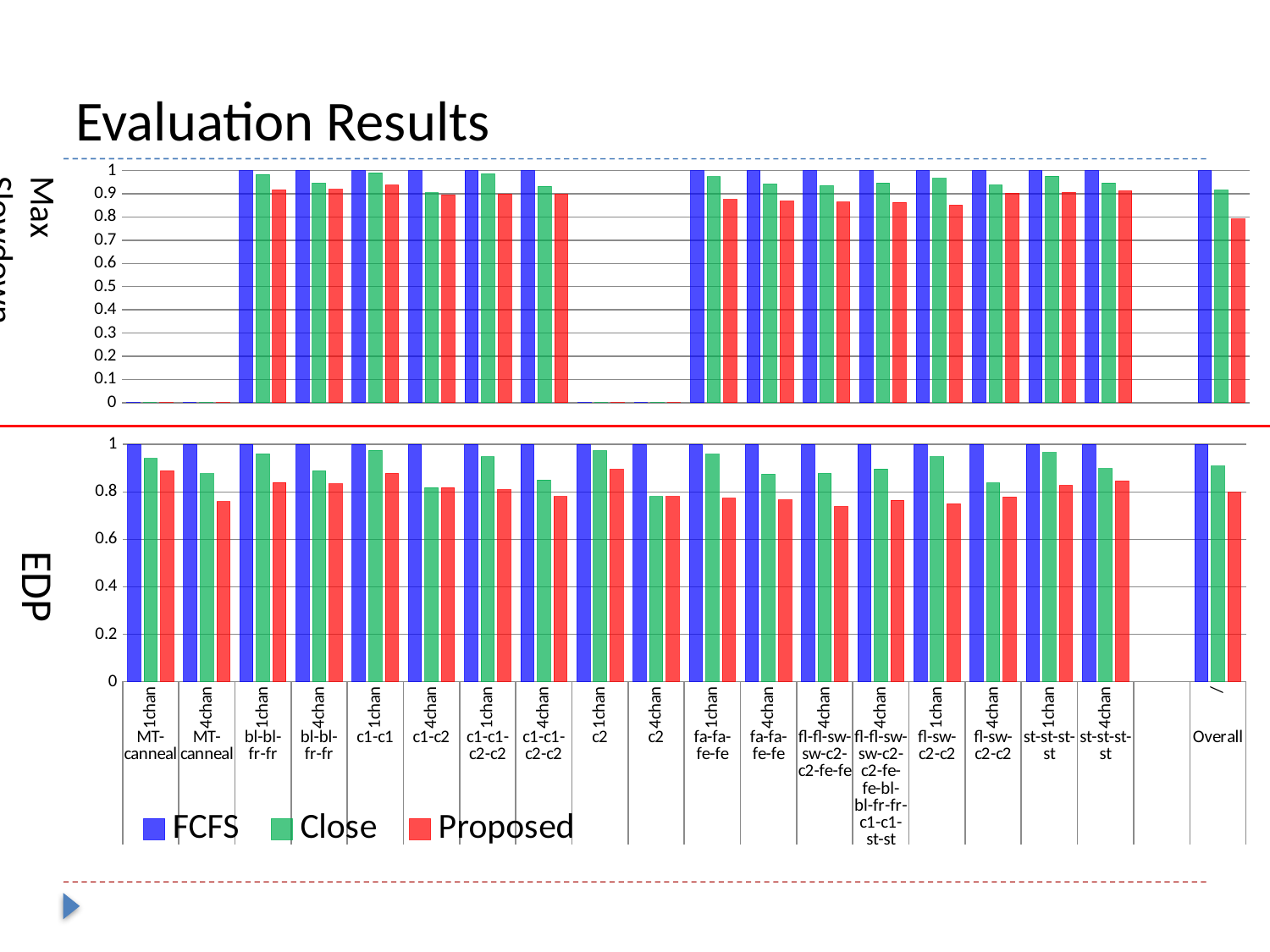
What are the three series named in the legend? FCFS, Close, Proposed In the EDP chart, is the Close value for Overall greater or less than 0.8? greater In the EDP chart, for MT-canneal 1chan, which is larger: Close or Proposed? Close How many series does the legend list for the charts? 3 In the EDP chart, is the Proposed value for MT-canneal 4chan greater or less than 0.8? less In the EDP chart, is the Proposed value for fl-fl-sw-sw-c2-c2-fe-fe 4chan greater or less than 0.8? less What kind of chart is the EDP chart at the bottom of the slide? bar chart Which series is shown in blue in the legend? FCFS In the Max Slowdown chart, which series has the lowest value for Overall? Proposed In the Max Slowdown chart, for Overall, which is larger: Close or Proposed? Close